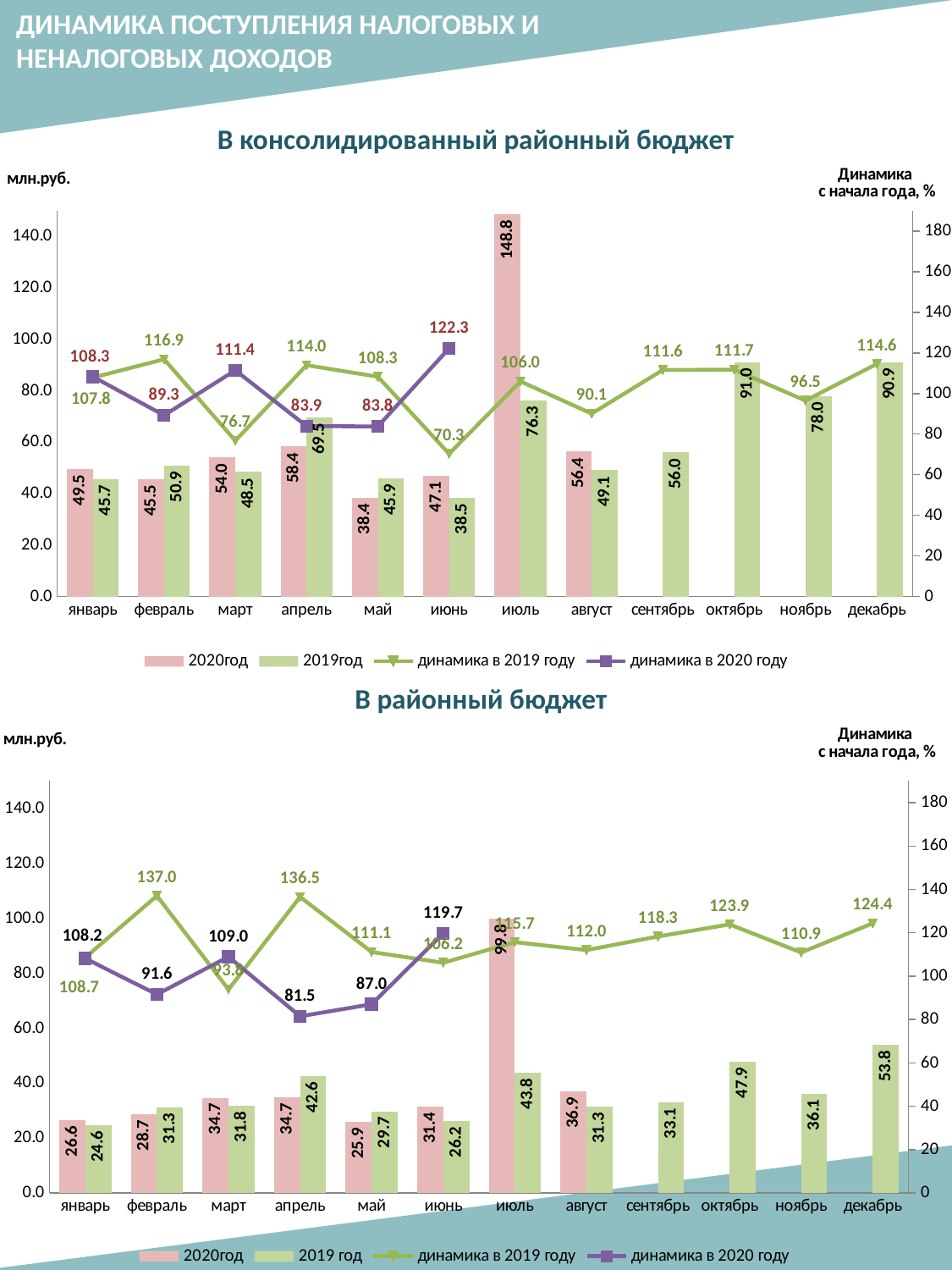
How many series does the legend of the chart 'В консолидированный районный бюджет' list? 4 In the chart 'В консолидированный районный бюджет', what is the value of the 2020 bar for июль? 148.8 In the chart 'В районный бюджет', what is the value of the 2019 bar for декабрь? 53.8 In the chart 'В районный бюджет', which is larger for апрель: the 2020 bar or the 2019 bar? 2019 bar In the chart 'В консолидированный районный бюджет', what is the value of the 2019 bar for октябрь? 91.0 In the chart 'В консолидированный районный бюджет', which month has the lowest 2019 bar? июнь In the chart 'В консолидированный районный бюджет', what is the value of 'динамика в 2020 году' for июнь? 122.3 In the chart 'В районный бюджет', what is the value of 'динамика в 2020 году' for апрель? 81.5 In the chart 'В районный бюджет', which month has the highest value of 'динамика в 2019 году'? февраль How many months are shown on the x axis of the chart 'В районный бюджет'? 12 In the chart 'В консолидированный районный бюджет', what is the difference between the 2020 and 2019 bars for июль? 72.5 In the chart 'В консолидированный районный бюджет', which month has the highest 2020 bar? июль